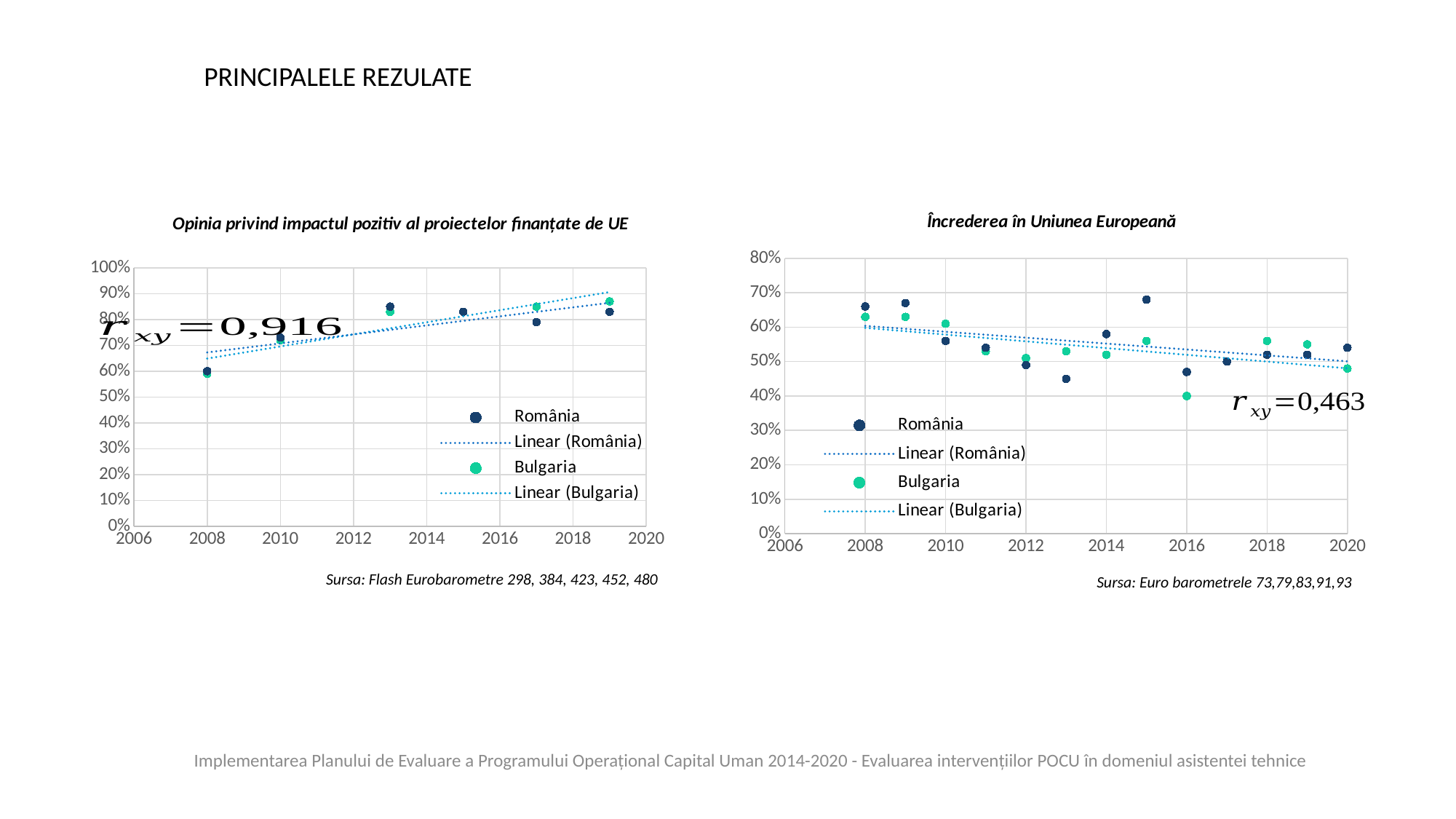
What correlation coefficient r_xy is printed on the right chart, 'Încrederea în Uniunea Europeană'? 0,463 In the right chart, 'Încrederea în Uniunea Europeană', in which year is the Bulgaria value lowest? 2016 In the right chart, 'Încrederea în Uniunea Europeană', is the value for Bulgaria in 2016 greater or less than 50%? less In the right chart, 'Încrederea în Uniunea Europeană', is the value for România in 2015 greater or less than 60%? greater How many România data points are plotted in the left chart, 'Opinia privind impactul pozitiv al proiectelor finanțate de UE'? 6 What kind of chart is the left chart, 'Opinia privind impactul pozitiv al proiectelor finanțate de UE'? scatter chart In the right chart, 'Încrederea în Uniunea Europeană', do the trend lines for România and Bulgaria rise or fall from 2008 to 2020? fall In the left chart, 'Opinia privind impactul pozitiv al proiectelor finanțate de UE', is the value for Bulgaria in 2019 greater or less than 80%? greater In the right chart, 'Încrederea în Uniunea Europeană', which is larger in 2013: the value for România or for Bulgaria? Bulgaria In the left chart, 'Opinia privind impactul pozitiv al proiectelor finanțate de UE', do the România values generally rise or fall from 2008 to 2019? rise How many entries does the legend of the right chart, 'Încrederea în Uniunea Europeană', list? 4